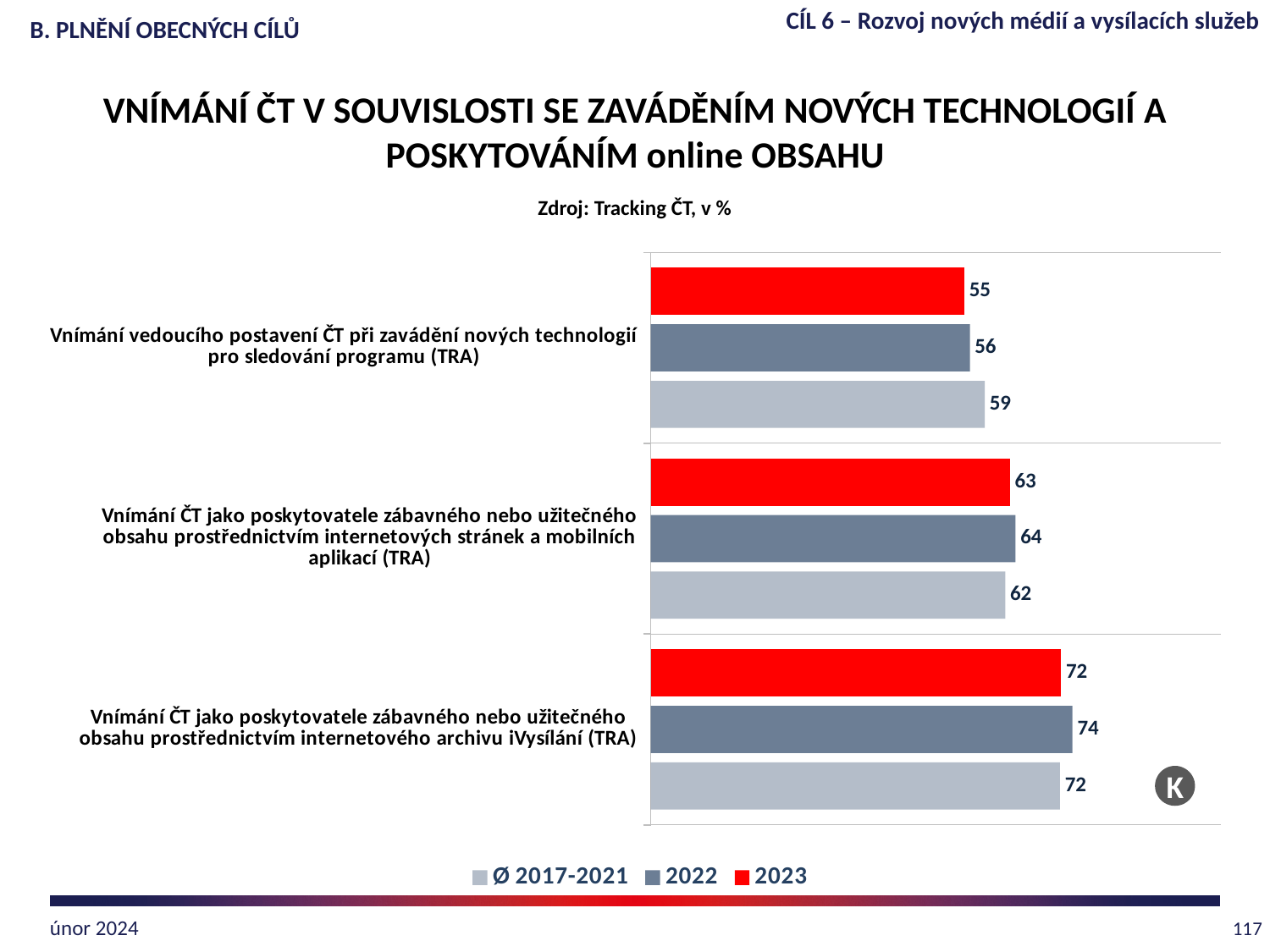
What is the difference between the 2022 and 2023 values for 'Vnímání ČT jako poskytovatele zábavného nebo užitečného obsahu prostřednictvím internetového archivu iVysílání (TRA)'? 2 How many categories are shown in the chart? 3 For 'Vnímání ČT jako poskytovatele zábavného nebo užitečného obsahu prostřednictvím internetových stránek a mobilních aplikací (TRA)', which is larger: the 2022 value or the Ø 2017-2021 value? 2022 Which series is shown in red in the legend? 2023 What is the 2023 value for 'Vnímání vedoucího postavení ČT při zavádění nových technologií pro sledování programu (TRA)'? 55 Which category has the highest 2023 value? Vnímání ČT jako poskytovatele zábavného nebo užitečného obsahu prostřednictvím internetového archivu iVysílání (TRA) How many series does the legend list? 3 What is the Ø 2017-2021 value for 'Vnímání ČT jako poskytovatele zábavného nebo užitečného obsahu prostřednictvím internetových stránek a mobilních aplikací (TRA)'? 62 What is the difference between the Ø 2017-2021 and 2023 values for 'Vnímání vedoucího postavení ČT při zavádění nových technologií pro sledování programu (TRA)'? 4 Which category has the lowest Ø 2017-2021 value? Vnímání vedoucího postavení ČT při zavádění nových technologií pro sledování programu (TRA) What kind of chart is shown on the slide? Bar chart What is the 2022 value for 'Vnímání ČT jako poskytovatele zábavného nebo užitečného obsahu prostřednictvím internetového archivu iVysílání (TRA)'? 74